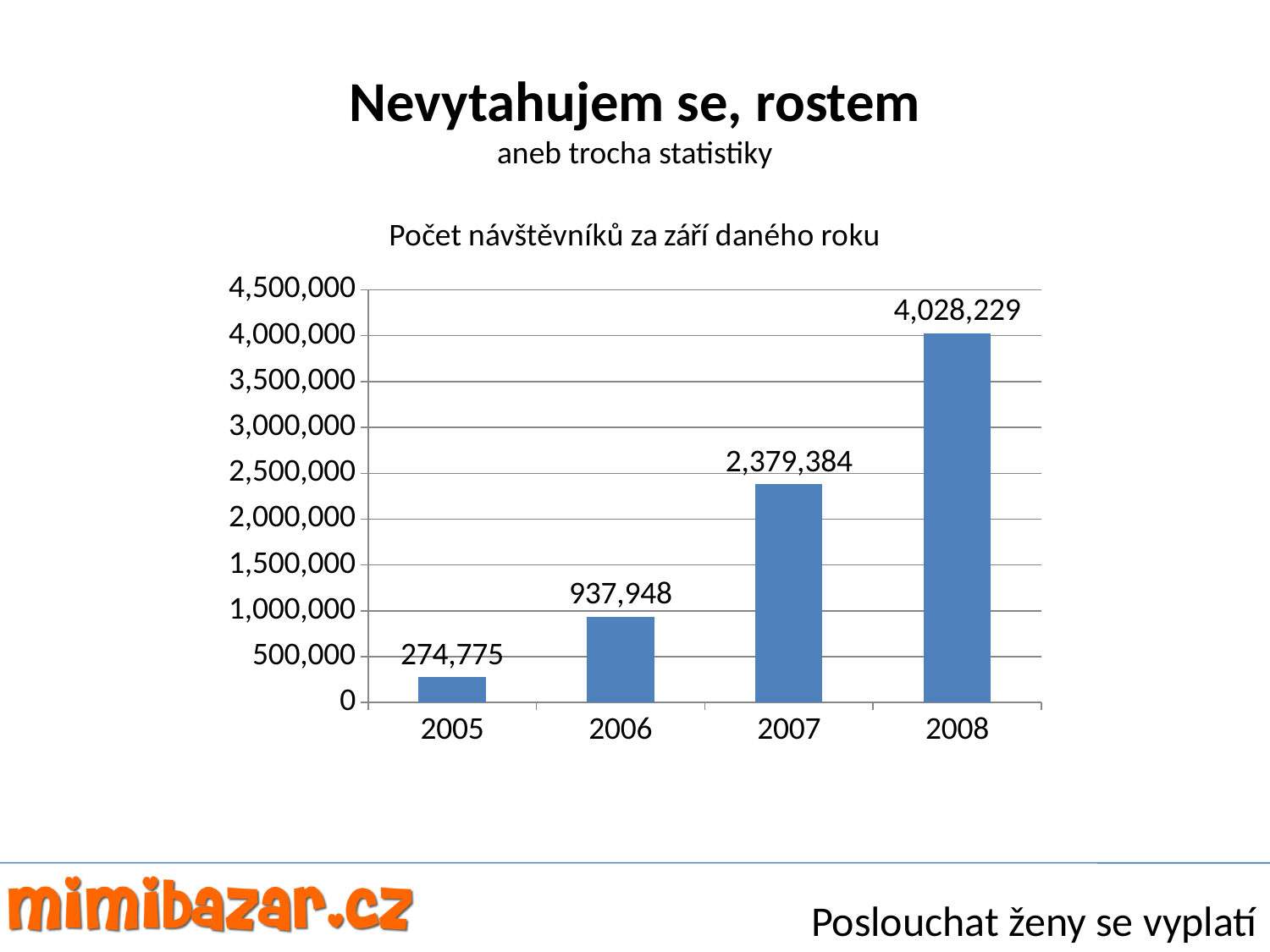
What is the value for 2005? 274,775 Which year has the lowest value? 2005 What is the difference between the values for 2006 and 2005? 663,173 What kind of chart is shown? bar chart What is the value for 2007? 2,379,384 What is the difference between the values for 2008 and 2007? 1,648,845 What is the value for 2008? 4,028,229 Which is larger, the value for 2006 or the value for 2007? 2007 What is the value for 2006? 937,948 How many years are shown on the x axis? 4 Is the value for 2008 greater or less than 4,000,000? greater Which year has the highest value? 2008